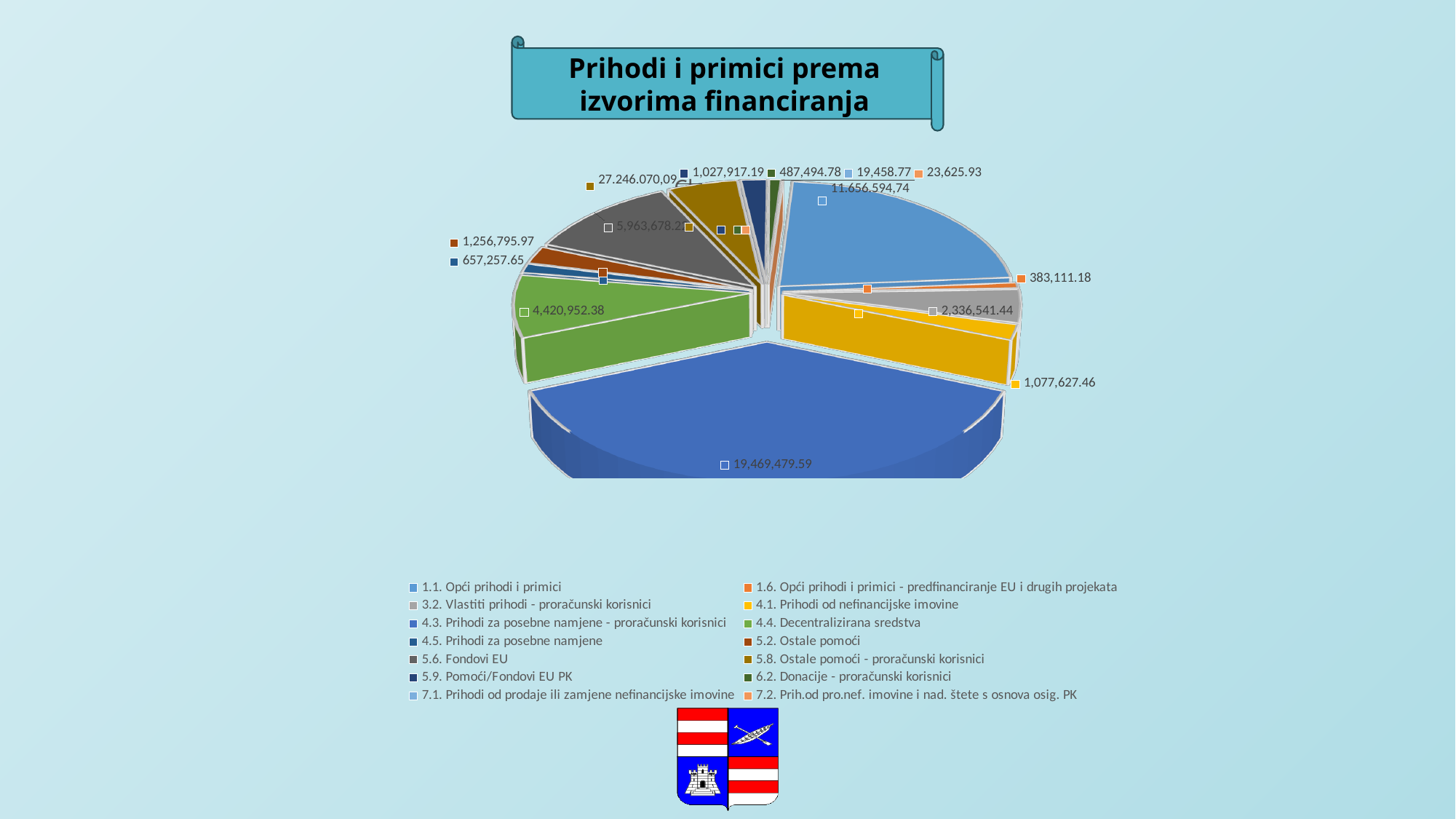
How many categories does the legend list? 14 What is the title of the chart? Prihodi i primici prema izvorima financiranja Which category has the largest slice of the pie? 4.3. Prihodi za posebne namjene - proračunski korisnici What is the difference between the values for 3.2. Vlastiti prihodi - proračunski korisnici and 4.1. Prihodi od nefinancijske imovine? 1,258,913.98 What is the value for 4.3. Prihodi za posebne namjene - proračunski korisnici? 19,469,479.59 What kind of chart is shown on the slide? pie chart What is the value for 1.1. Opći prihodi i primici? 11.656.594,74 What is the value for 7.2. Prih.od pro.nef. imovine i nad. štete s osnova osig. PK? 23,625.93 Which is larger: 4.4. Decentralizirana sredstva or 3.2. Vlastiti prihodi - proračunski korisnici? 4.4. Decentralizirana sredstva What is the value for 4.4. Decentralizirana sredstva? 4,420,952.38 Which category has the smallest slice of the pie? 7.1. Prihodi od prodaje ili zamjene nefinancijske imovine What is the value for 4.1. Prihodi od nefinancijske imovine? 1,077,627.46